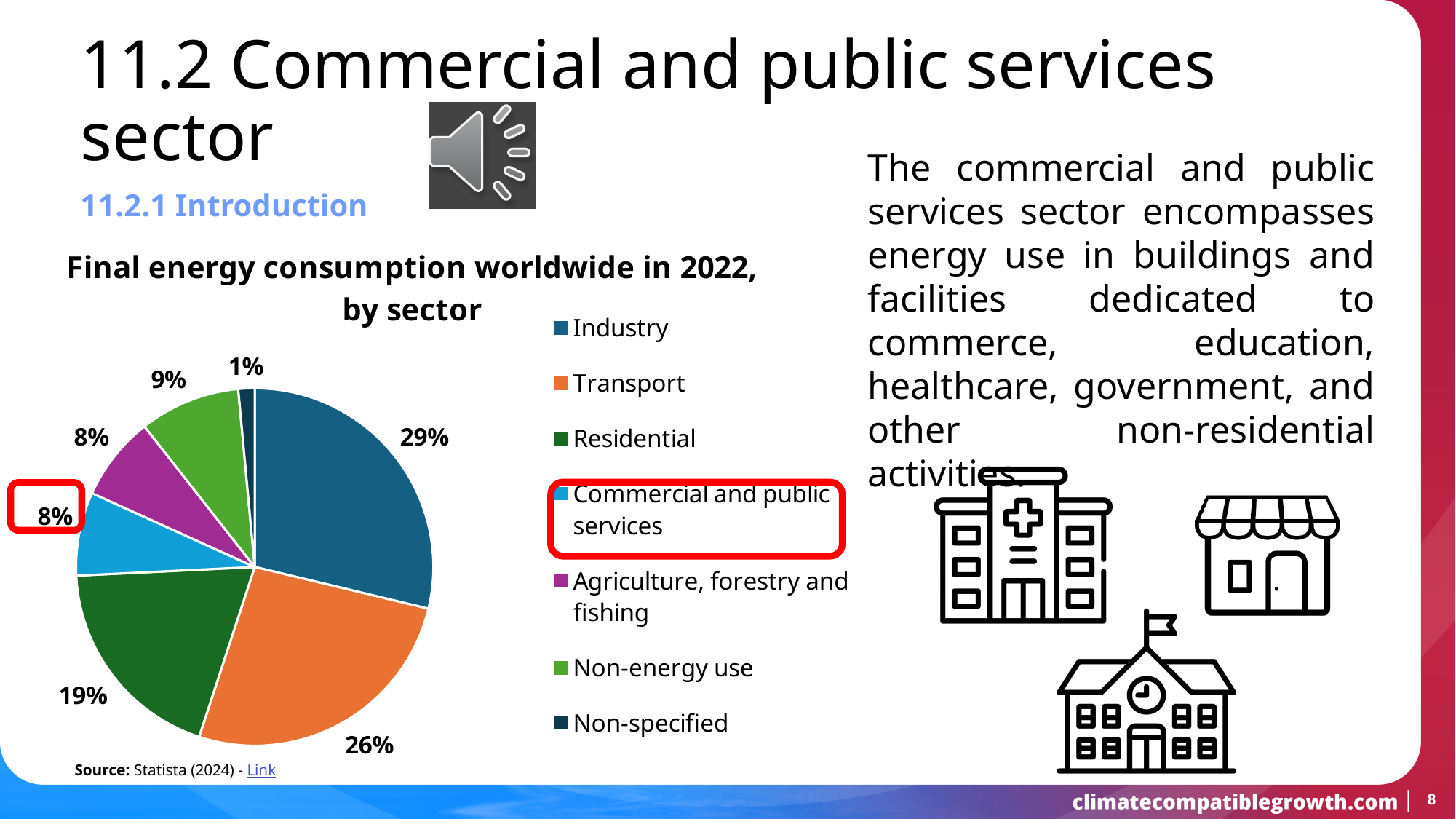
How many sectors does the legend list? 7 Which sector has the smallest share of final energy consumption? Non-specified What share of final energy consumption does the Residential sector account for? 19% What kind of chart is shown on the slide? Pie chart What is the difference in percentage points between the Industry and Transport shares? 3 What is the title of the chart? Final energy consumption worldwide in 2022, by sector What share of final energy consumption does Non-energy use account for? 9% What share of final energy consumption does Industry account for? 29% Which sector has the largest share of final energy consumption? Industry Which has a larger share, Residential or Non-energy use? Residential What share of final energy consumption does Transport account for? 26% What share of final energy consumption does Commercial and public services account for? 8%